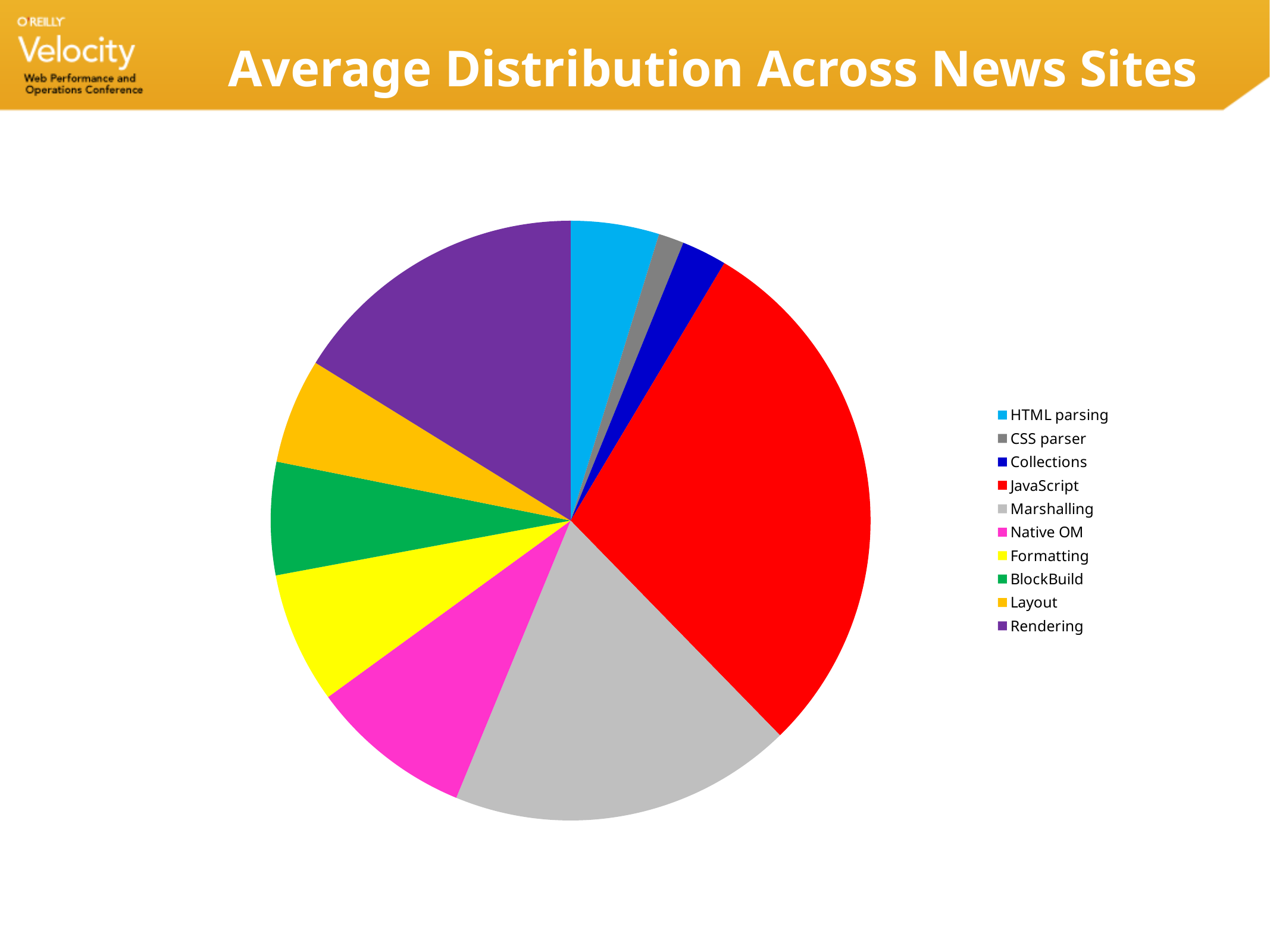
Which category has the largest slice of the pie? JavaScript How many categories does the pie chart have? 10 What is the title of the chart? Average Distribution Across News Sites Which slice is larger, HTML parsing or Collections? HTML parsing What colour is the JavaScript slice in the pie chart? red Which category is the second-largest slice of the pie? Marshalling Which slice is larger, Rendering or Layout? Rendering Which slice is larger, Marshalling or Rendering? Marshalling Which category has the smallest slice of the pie? CSS parser What kind of chart is shown on the slide? pie chart